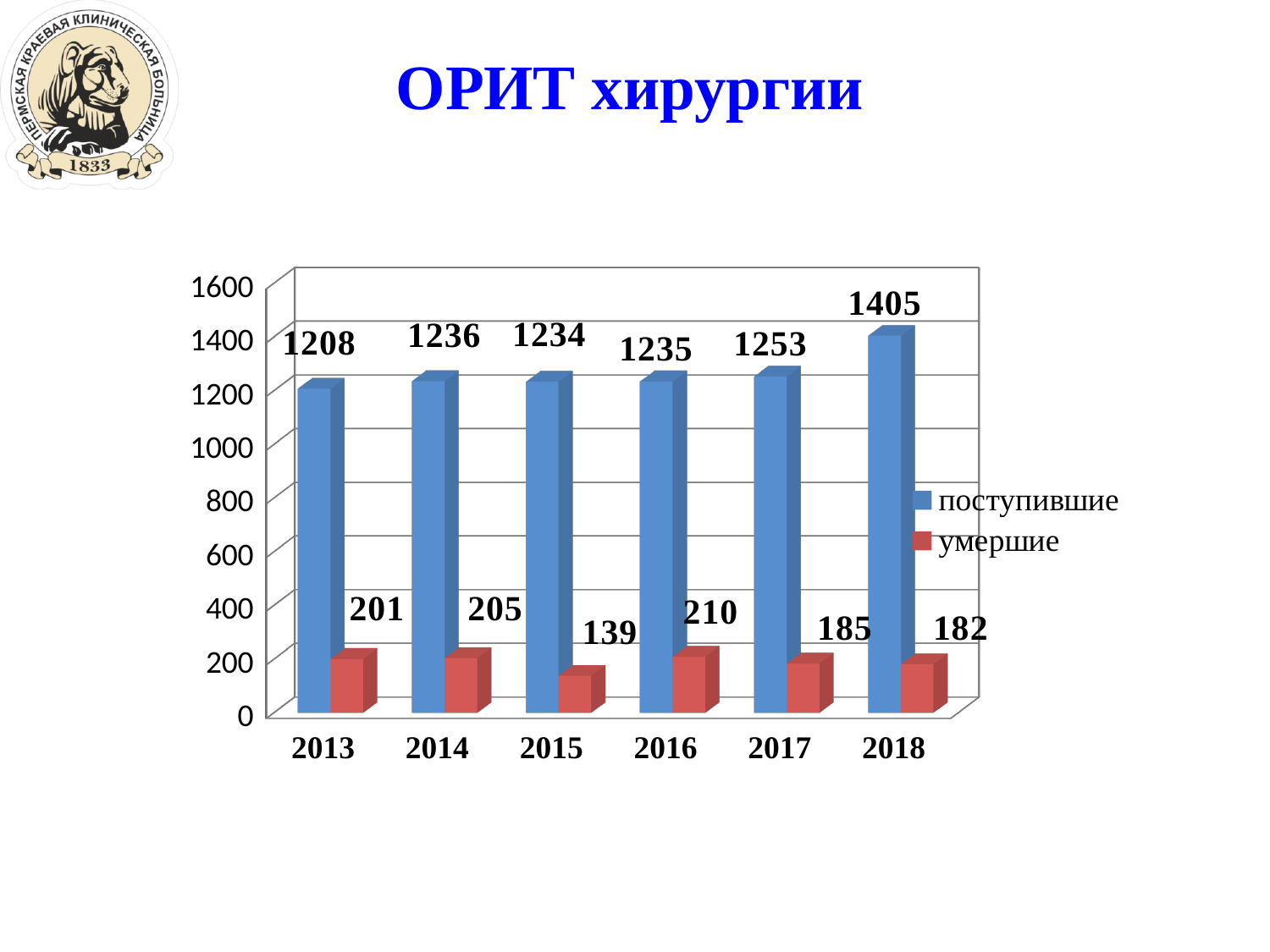
How many years are shown on the x axis? 6 Which year has the lowest value for умершие? 2015 What is the title of the slide? ОРИТ хирургии What is the value for умершие in 2015? 139 Which year has the highest value for поступившие? 2018 What is the value for поступившие in 2018? 1405 Which is larger: умершие in 2014 or умершие in 2017? умершие in 2014 What kind of chart is shown on the slide? bar chart Which year has the highest value for умершие? 2016 What is the value for поступившие in 2013? 1208 How many series does the legend list? 2 What is the difference between поступившие in 2018 and поступившие in 2017? 152